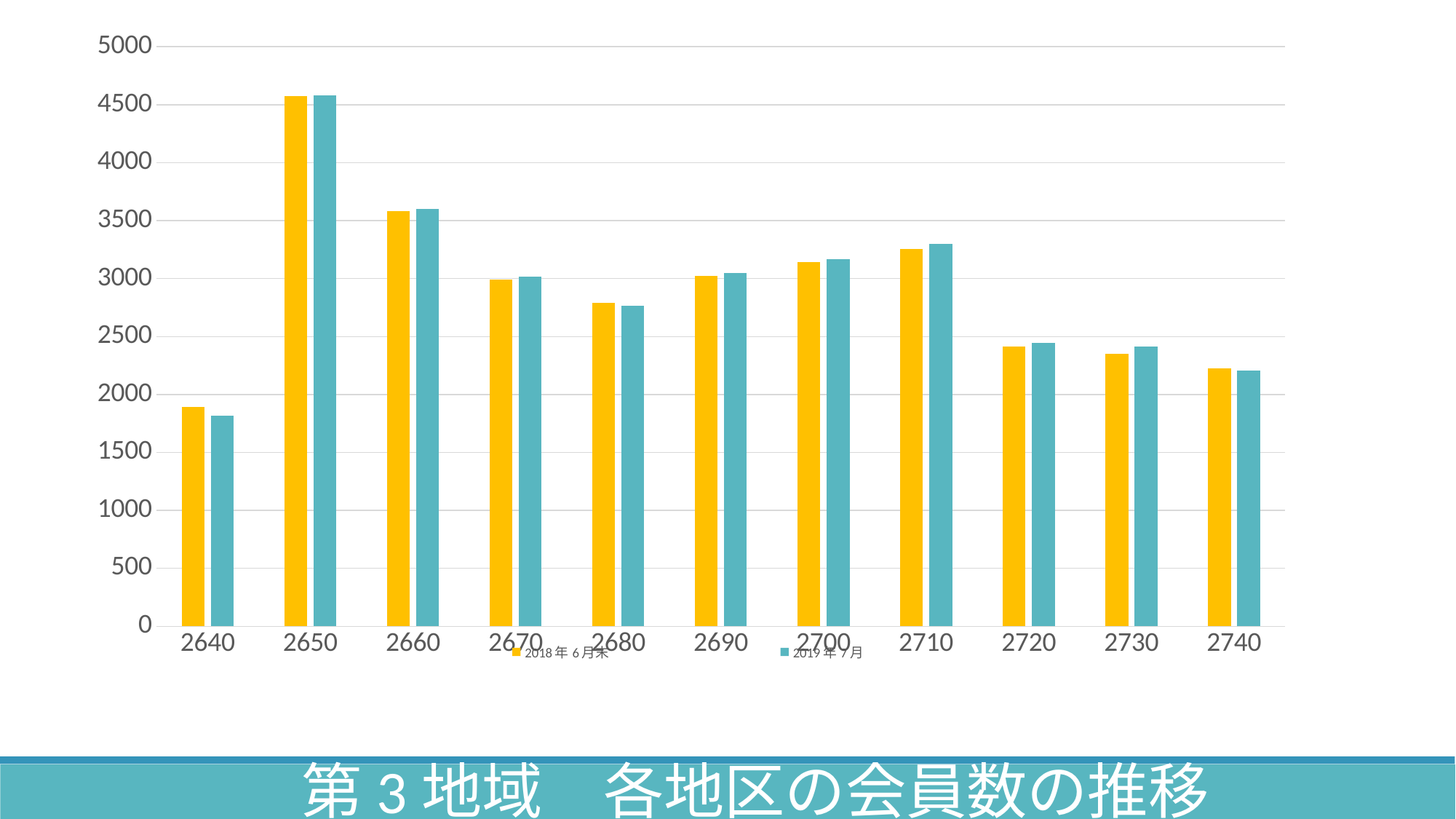
What is the title shown at the bottom of the slide? 第3地域 各地区の会員数の推移 Is the 2018年6月末 value for 2650 greater or less than 4000? greater Which district has the lowest value for 2019年7月? 2640 How many series does the legend list? 2 Is the 2019年7月 value for 2640 greater or less than 2000? less Is the 2018年6月末 value for 2680 greater or less than 3000? less For 2019年7月, which district has the larger value, 2680 or 2690? 2690 Which district has the highest value for 2018年6月末? 2650 How many categories (districts) are shown on the x axis? 11 What kind of chart is shown on the slide? bar chart For 2018年6月末, which district has the larger value, 2650 or 2660? 2650